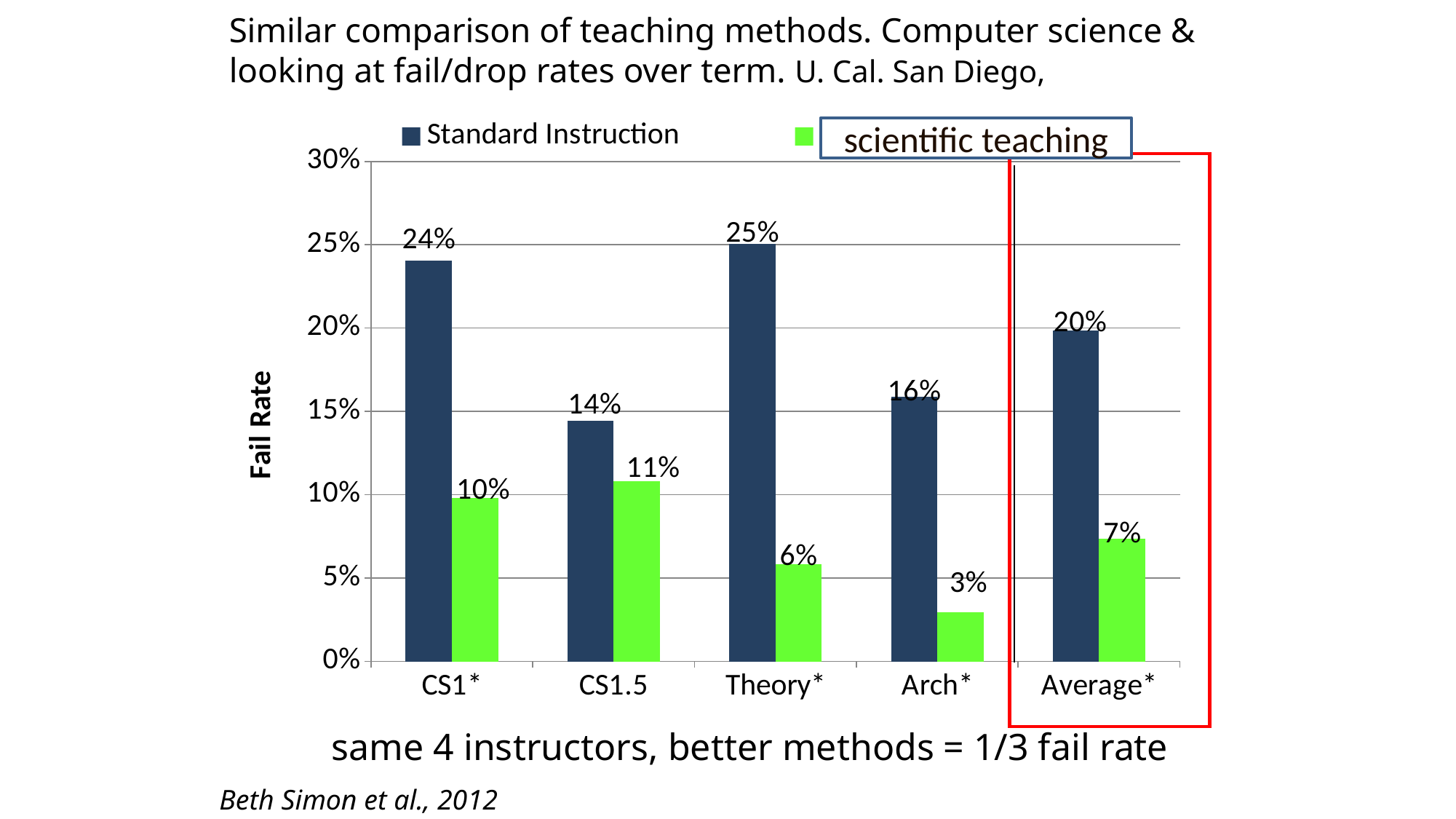
How many categories are shown on the x axis? 5 How many series does the legend list? 2 What is the Standard Instruction fail rate for Average*? 20% What is the label of the y axis? Fail Rate Which category has the highest Standard Instruction fail rate? Theory* What kind of chart is shown on the slide? Bar chart What is the difference between the Standard Instruction and scientific teaching fail rates for Theory*? 19% Which category has the lowest scientific teaching fail rate? Arch* What is the scientific teaching fail rate for Arch*? 3% What is the Standard Instruction fail rate for CS1*? 24% Is the Standard Instruction fail rate for Arch* greater or less than 15%? greater Which is larger: the scientific teaching fail rate for CS1.5 or for CS1*? CS1.5